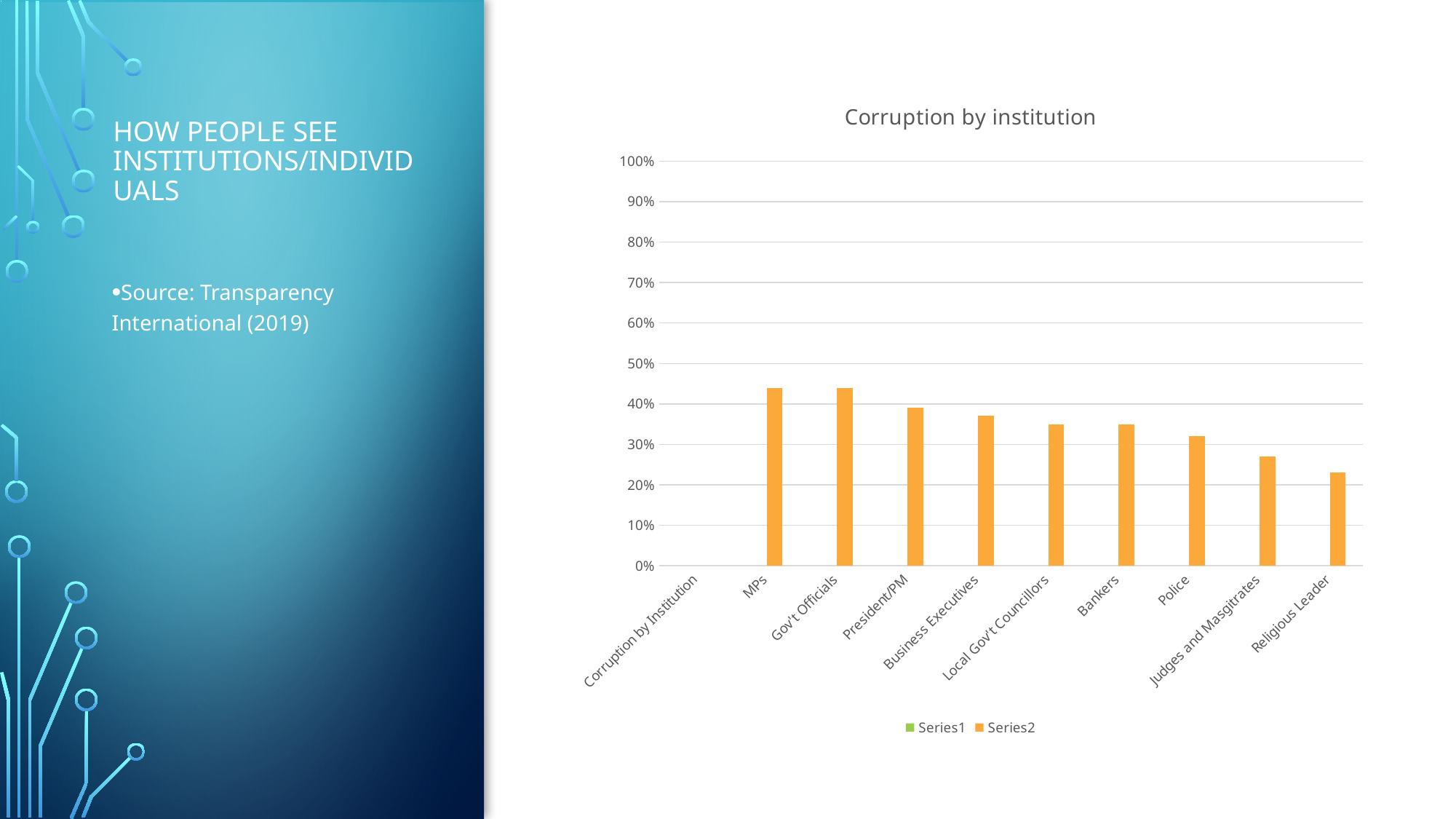
How many series does the legend list? 2 Which category has the lowest value in the chart? Religious Leader Which has a larger value, Police or Religious Leader? Police What is the title of the chart? Corruption by institution Is the value for Police greater or less than 30%? greater Do the bar values generally rise or fall from MPs to Religious Leader along the x axis? fall Is the value for MPs greater or less than 40%? greater What type of chart is shown on the slide? Bar chart Is the value for Judges and Masgitrates greater or less than 30%? less Which has a larger value, President/PM or Judges and Masgitrates? President/PM